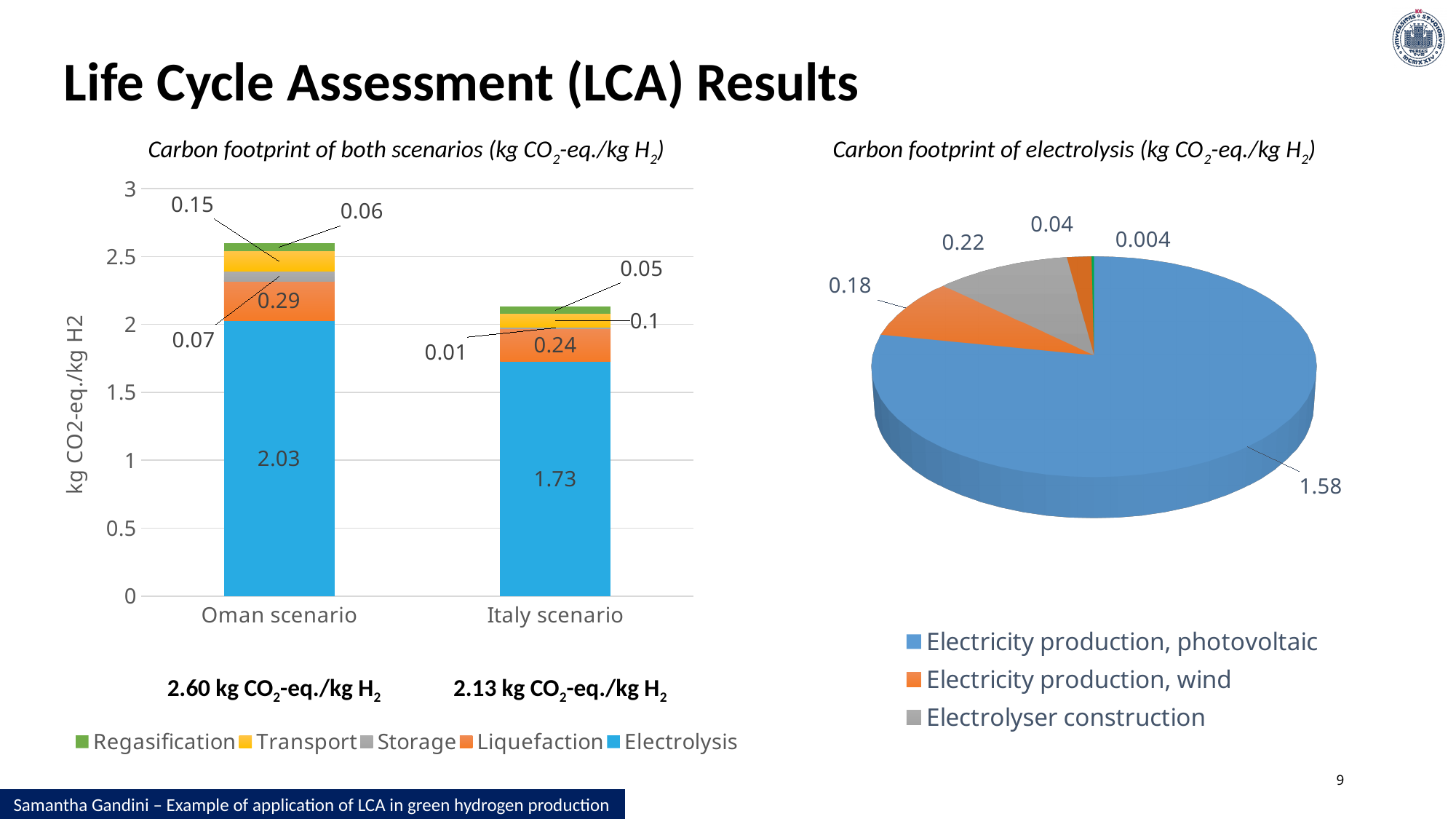
What kind of chart is the 'Carbon footprint of electrolysis' chart on the right? Pie chart In the 'Carbon footprint of both scenarios' chart, what is the Liquefaction value for the Italy scenario? 0.24 In the 'Carbon footprint of both scenarios' chart, what is the total carbon footprint of the Italy scenario? 2.13 kg CO2-eq./kg H2 How many series does the legend of the 'Carbon footprint of both scenarios' chart list? 5 What kind of chart is the 'Carbon footprint of both scenarios' chart on the left? Stacked bar chart In the 'Carbon footprint of both scenarios' chart, what is the total carbon footprint of the Oman scenario? 2.60 kg CO2-eq./kg H2 In the 'Carbon footprint of electrolysis' pie chart, which category has the largest slice? Electricity production, photovoltaic In the 'Carbon footprint of both scenarios' chart, what is the Electrolysis value for the Oman scenario? 2.03 In the 'Carbon footprint of electrolysis' pie chart, what is the value for Electricity production, photovoltaic? 1.58 In the 'Carbon footprint of both scenarios' chart, which scenario has the larger total carbon footprint? Oman scenario In the 'Carbon footprint of both scenarios' chart, what is the Storage value for the Oman scenario? 0.07 In the 'Carbon footprint of both scenarios' chart, what is the difference between the Electrolysis values of the Oman and Italy scenarios? 0.3